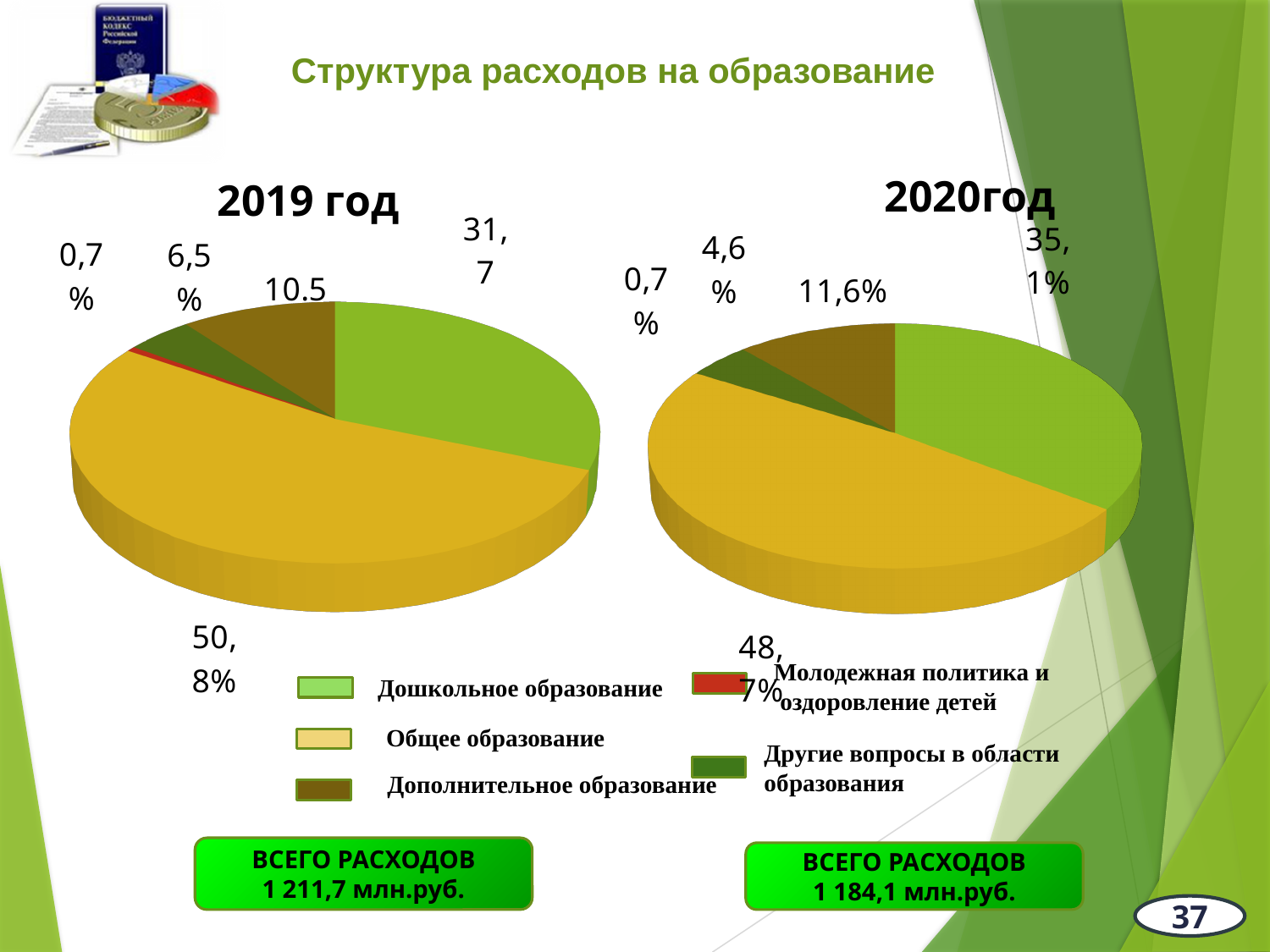
What total expenses (ВСЕГО РАСХОДОВ) are shown under the 2019 год chart? 1 211,7 млн.руб. In the 2020год chart, what share is shown for Дополнительное образование? 11,6% In the 2019 год chart, which is larger: Дошкольное образование or Дополнительное образование? Дошкольное образование In the 2020год chart, what share is shown for Дошкольное образование? 35,1% What kind of chart is used to show the structure of education expenses for 2019 and 2020? pie chart In the 2020год chart, which category has the largest share? Общее образование How many slices does the 2019 год pie chart have? 5 In the 2019 год chart, which category has the smallest share? Молодежная политика и оздоровление детей In the 2020год chart, what is the difference between the shares of Общее образование and Дошкольное образование? 13,6% How many categories does the legend list? 5 In the 2020год chart, what share is shown for Другие вопросы в области образования? 4,6% In the 2019 год chart, what share is shown for Общее образование? 50,8%